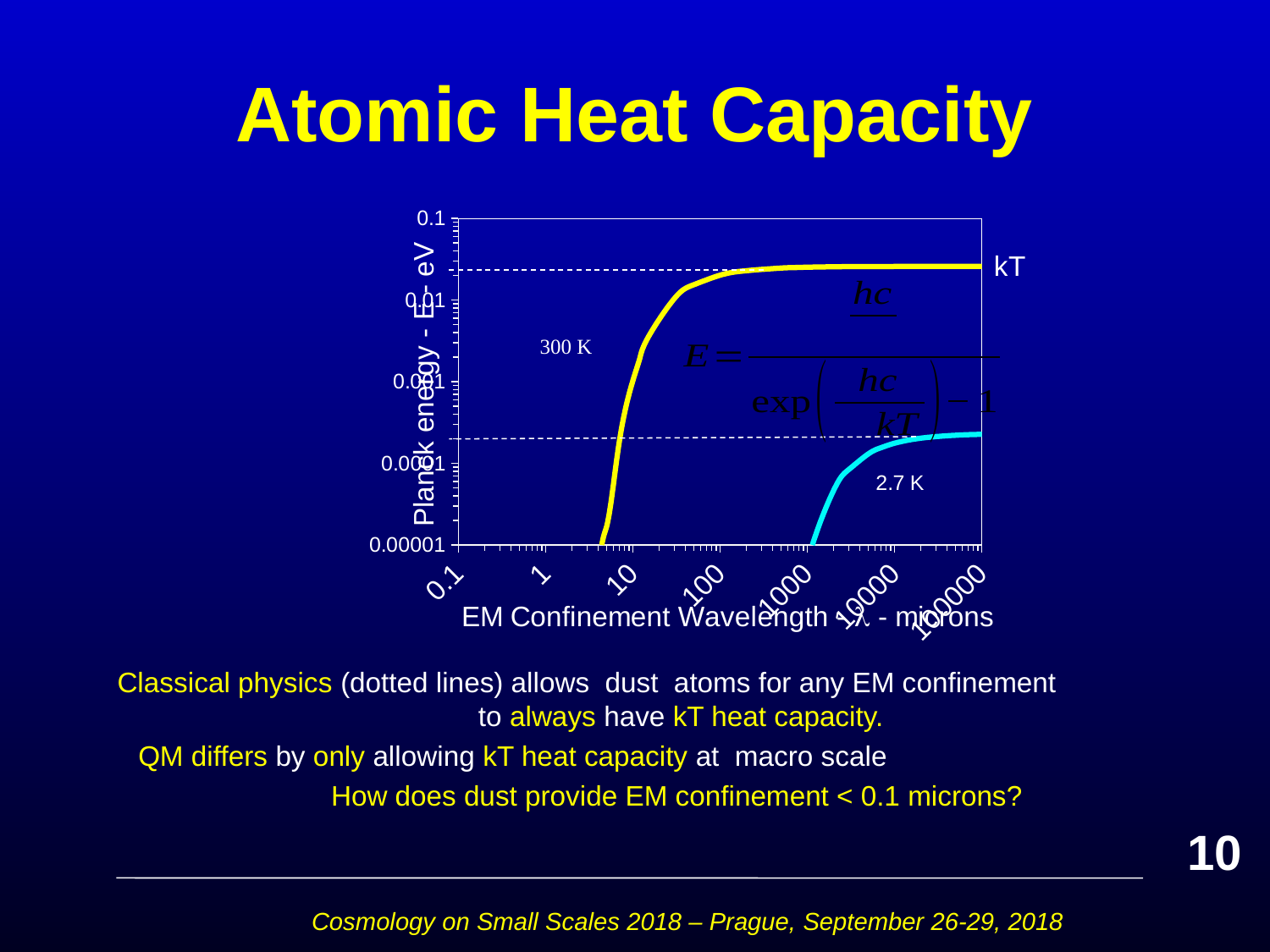
What is the lowest tick value shown on the x axis of the chart? 0.1 How many temperature curves are plotted on the chart? 2 Does the Planck energy of the 300 K curve rise or fall as the wavelength increases along the x axis? rise What is the highest tick value shown on the y axis of the chart? 0.1 Which curve lies higher on the chart, the 300 K curve or the 2.7 K curve? 300 K Is the Planck energy of the 2.7 K curve at 100000 microns greater or less than 0.001 eV? less What is the label of the x axis of the chart? EM Confinement Wavelength - λ - microns What is the title of the slide containing the chart? Atomic Heat Capacity Is the Planck energy of the 300 K curve at 1000 microns greater or less than 0.01 eV? greater What kind of chart is shown on the slide? line chart Which curve reaches its plateau at a shorter wavelength, the 300 K curve or the 2.7 K curve? 300 K Is the Planck energy of the 2.7 K curve at 100000 microns greater or less than 0.0001 eV? greater